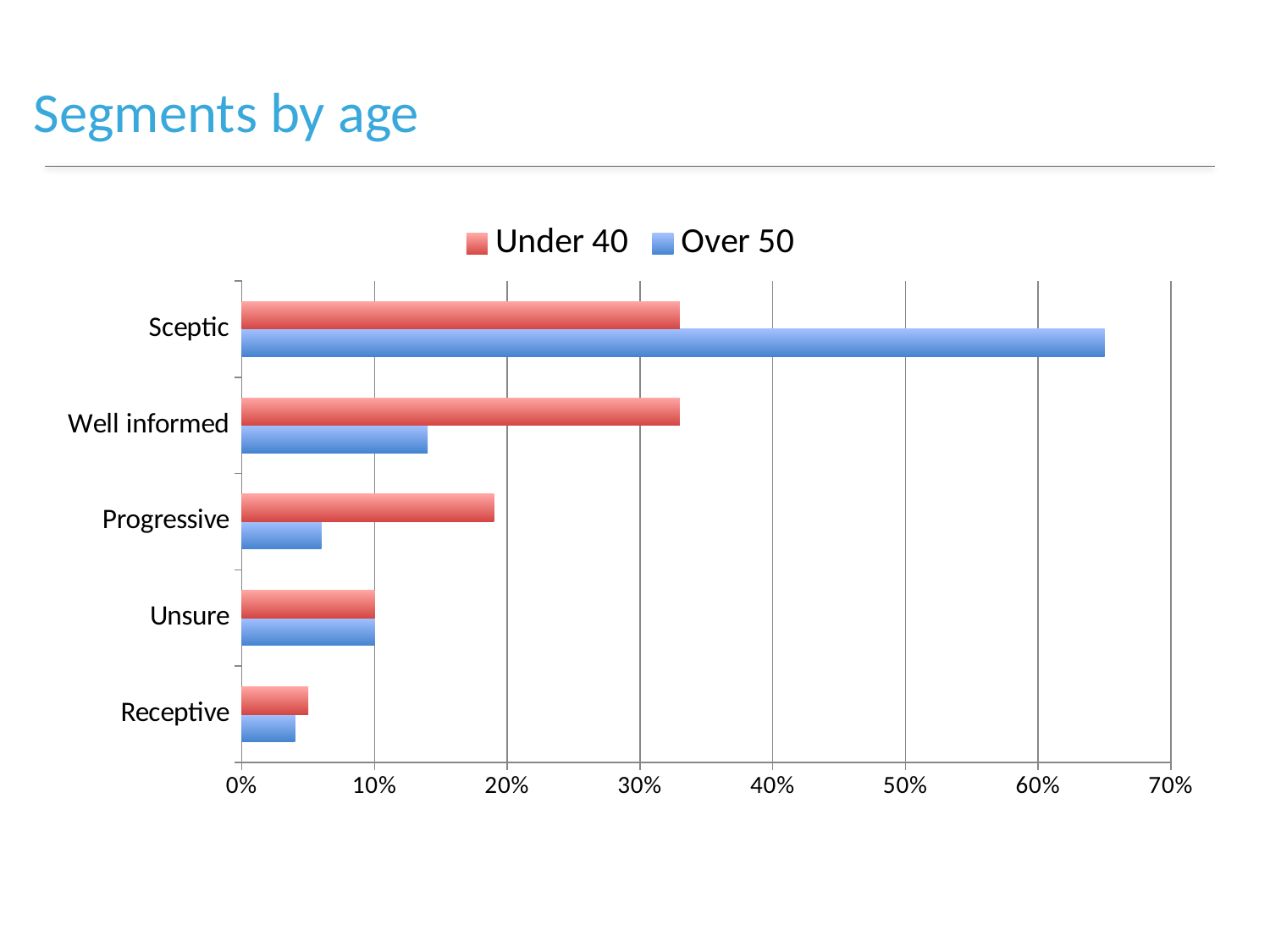
How many series does the legend list? 2 What is the Under 40 value for Unsure? 10% For Sceptic, which is larger: the Under 40 value or the Over 50 value? Over 50 Which category has the highest Over 50 value? Sceptic Which category has the lowest Under 40 value? Receptive Is the Over 50 value for Sceptic greater or less than 60%? greater What type of chart is shown on the slide? bar chart What is the Over 50 value for Unsure? 10% Which series is shown in blue? Over 50 For Well informed, which is larger: the Under 40 value or the Over 50 value? Under 40 What is the title of the slide containing the chart? Segments by age How many segment categories are shown on the chart? 5